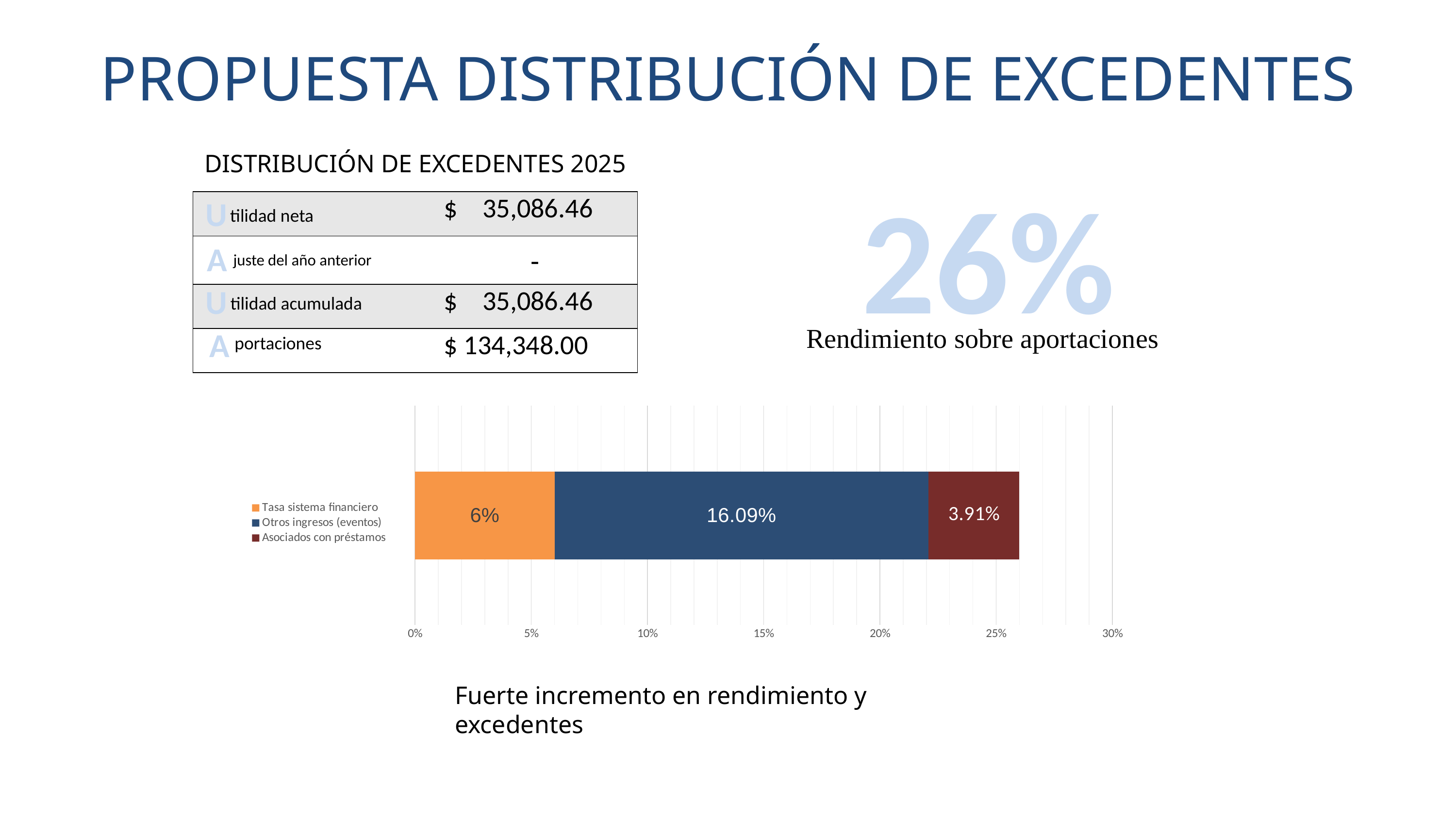
What colour is the Otros ingresos (eventos) segment in the chart? dark blue How many series does the chart legend list? 3 What kind of chart is shown on the slide? stacked bar chart Is the total length of the stacked bar greater or less than 20%? greater What is the total of the stacked bar? 26% Which series has the largest segment in the stacked bar? Otros ingresos (eventos) Which is larger, the Tasa sistema financiero segment or the Asociados con préstamos segment? Tasa sistema financiero Which series has the smallest segment in the stacked bar? Asociados con préstamos What is the value for Otros ingresos (eventos) in the chart? 16.09% What is the difference between the Otros ingresos (eventos) value and the Tasa sistema financiero value? 10.09% What is the value for Asociados con préstamos in the chart? 3.91% What is the value for Tasa sistema financiero in the chart? 6%